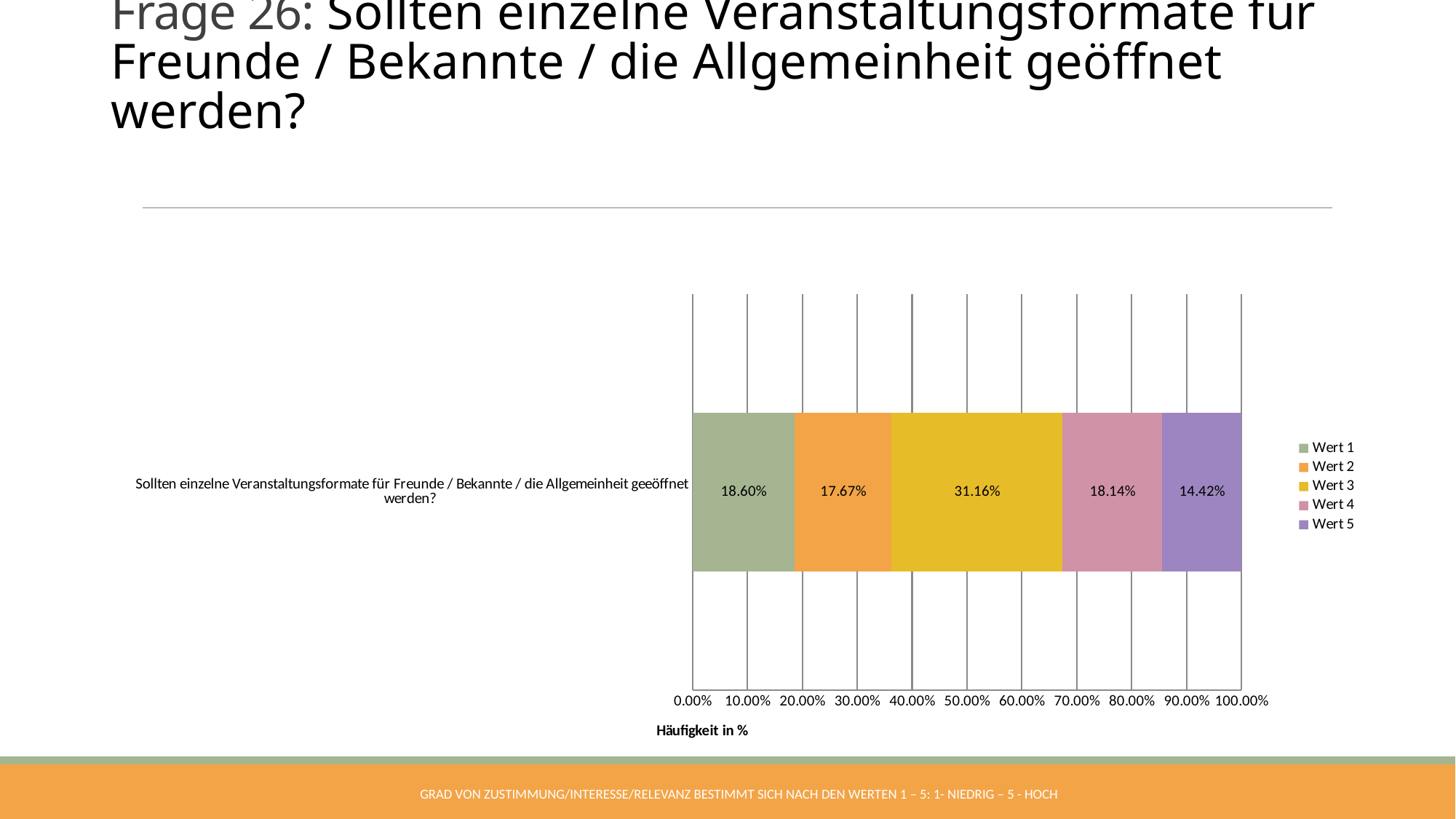
What kind of chart is shown on the slide? Stacked bar chart What is the value for Wert 5 in the chart? 14.42% Which series has the lowest value in the chart? Wert 5 What is the total of the stacked bar? 99.99% How many series does the legend list? 5 What is the value for Wert 1 in the chart? 18.60% What is the difference between the values for Wert 1 and Wert 5? 4.18% What is the difference between the values for Wert 3 and Wert 1? 12.56% Which series has the highest value in the chart? Wert 3 What is the title of the horizontal axis? Häufigkeit in % What is the value for Wert 3 in the chart? 31.16% Which is larger, the value for Wert 2 or the value for Wert 3? Wert 3